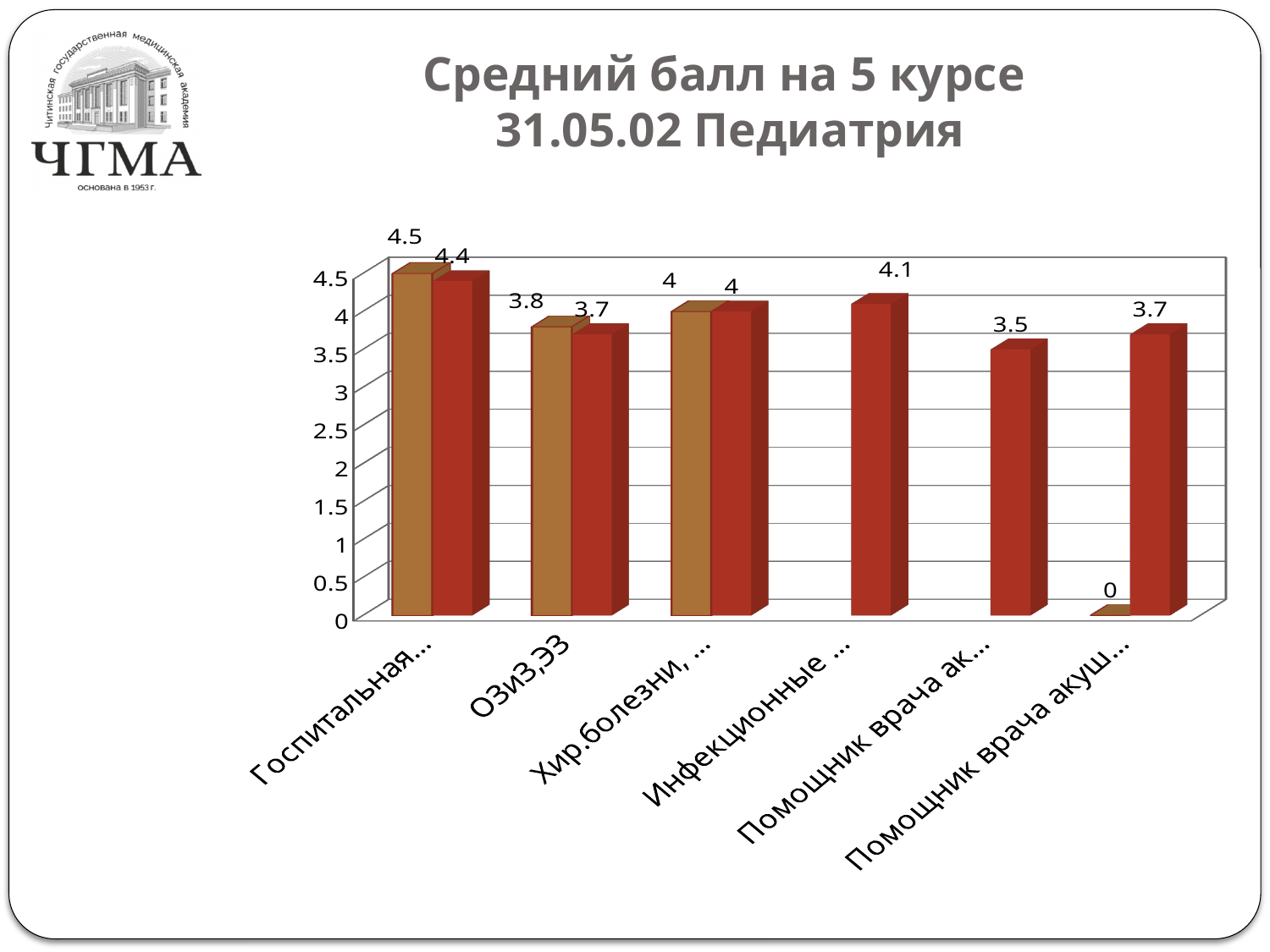
How many categories are shown along the x axis of the chart? 6 What is the value of the red bar for the fourth category, Инфекционные ...? 4.1 What is the value of the red (right) bar for the category ОЗиЗ,ЭЗ? 3.7 What is the value of the tan bar for the first (leftmost) category, Госпитальная...? 4.5 Is the red bar for the fifth category, Помощник врача ак..., greater or less than 4? less What is the difference between the tan bar and the red bar for the category ОЗиЗ,ЭЗ? 0.1 What kind of chart is shown on the slide? bar chart What is the title of the chart on the slide? Средний балл на 5 курсе 31.05.02 Педиатрия What is the difference between the two bars for the first category, Госпитальная...? 0.1 Which is larger: the red bar for Инфекционные ... or the red bar for the fifth category, Помощник врача ак...? Инфекционные ... What is the value of the tan (left) bar for the category ОЗиЗ,ЭЗ? 3.8 Which category has the highest bar in the chart? Госпитальная... (the first category)